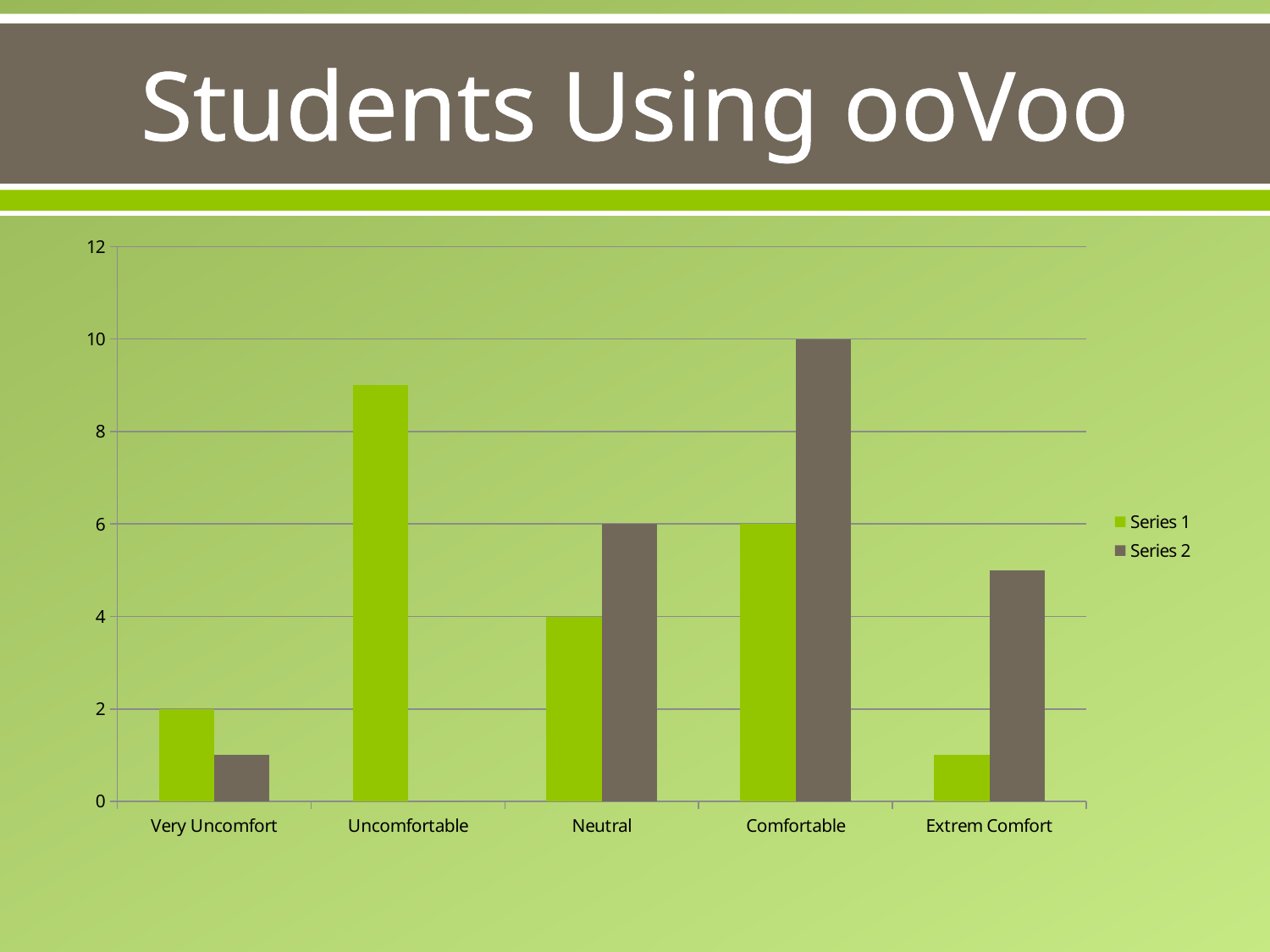
Is the Series 2 value for Extrem Comfort greater or less than 4? greater Which category has the lowest Series 1 value? Extrem Comfort How many series does the legend list? 2 What is the value of Series 2 for Neutral? 6 What is the difference between Series 2 and Series 1 for Comfortable? 4 What is the value of Series 1 for Very Uncomfort? 2 How many categories are shown on the x axis? 5 Which category has the highest Series 2 value? Comfortable Is the Series 1 value for Uncomfortable greater or less than 8? greater What is the value of Series 1 for Neutral? 4 Which category has the highest Series 1 value? Uncomfortable What is the value of Series 2 for Comfortable? 10